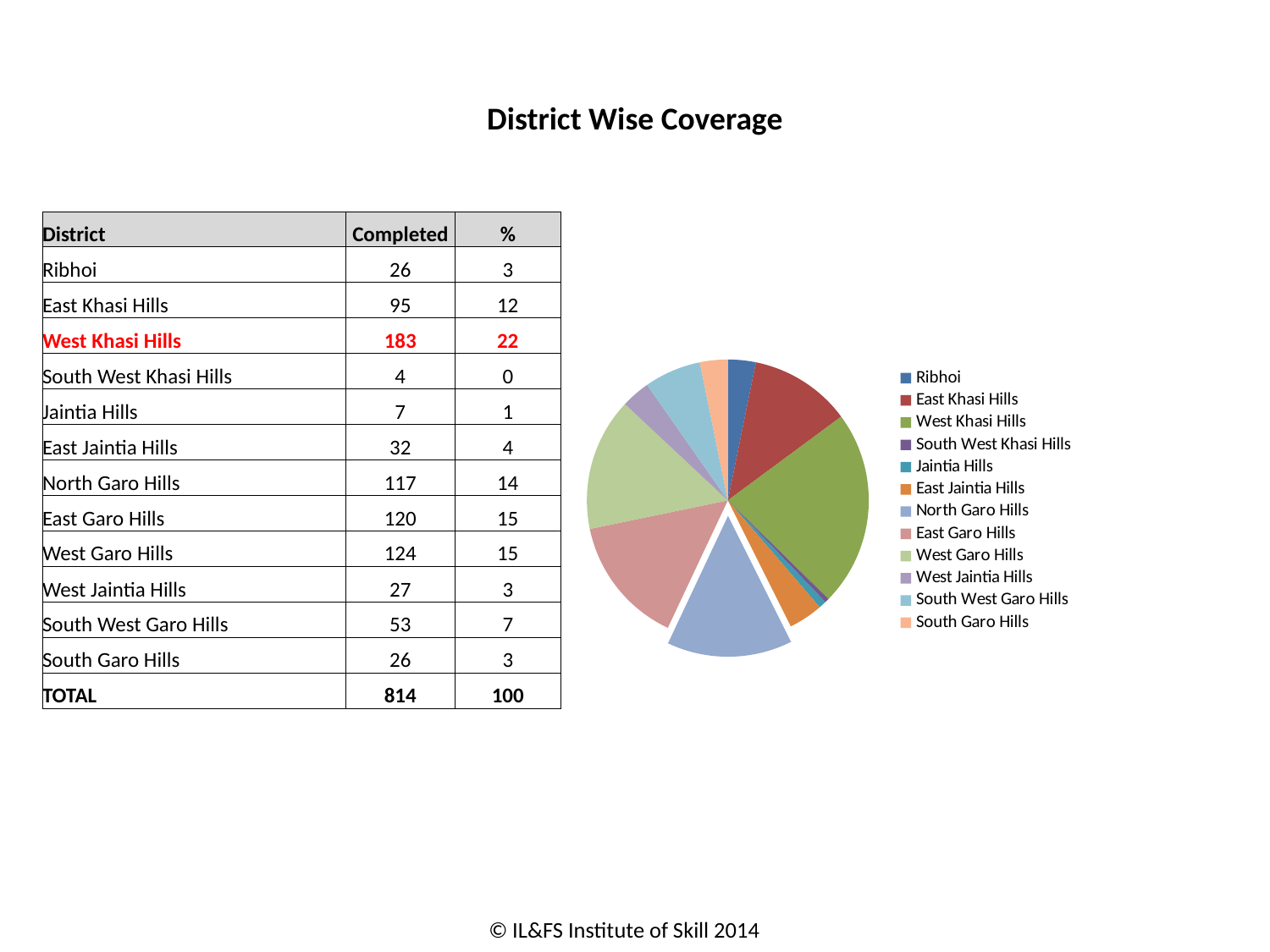
According to the table, how many completed are shown for North Garo Hills? 117 How many districts does the pie chart's legend list? 12 According to the table, how many completed are shown for West Khasi Hills? 183 Which slice of the pie chart is pulled out (exploded) from the rest? North Garo Hills Which district has the smallest slice of the pie chart? South West Khasi Hills Which slice is larger in the pie chart, East Khasi Hills or Ribhoi? East Khasi Hills What percentage share does West Khasi Hills have according to the table? 22 Which slice is larger in the pie chart, North Garo Hills or South West Garo Hills? North Garo Hills What is the difference in completed counts between West Garo Hills and East Garo Hills? 4 What kind of chart is shown on the slide? Pie chart Which district has the largest slice of the pie chart? West Khasi Hills What is the total completed count shown in the table? 814